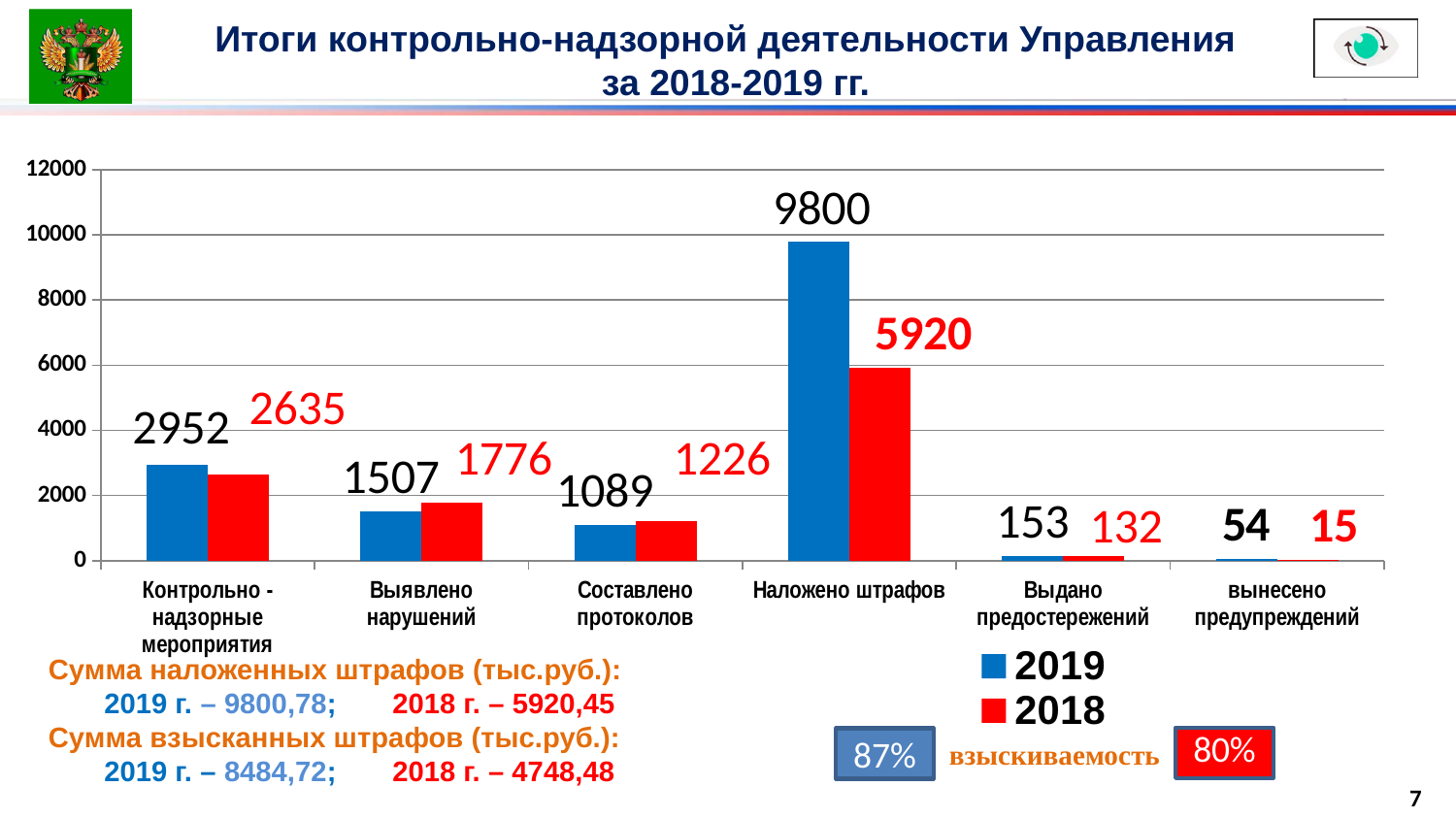
Which category has the lowest 2018 value? вынесено предупреждений Is the 2019 value for "Контрольно-надзорные мероприятия" greater or less than 2000? greater How many categories are shown on the x axis? 6 What is the 2019 value for "вынесено предупреждений"? 54 What kind of chart is shown on the slide? bar chart How many series does the legend list? 2 What is the difference between the 2019 and 2018 values for "Наложено штрафов"? 3880 What is the 2018 value for "Выявлено нарушений"? 1776 For "Составлено протоколов", which year has the larger value, 2019 or 2018? 2018 Which colour represents the 2018 series in the chart? red What is the 2019 value for "Наложено штрафов"? 9800 Which category has the highest 2019 value? Наложено штрафов